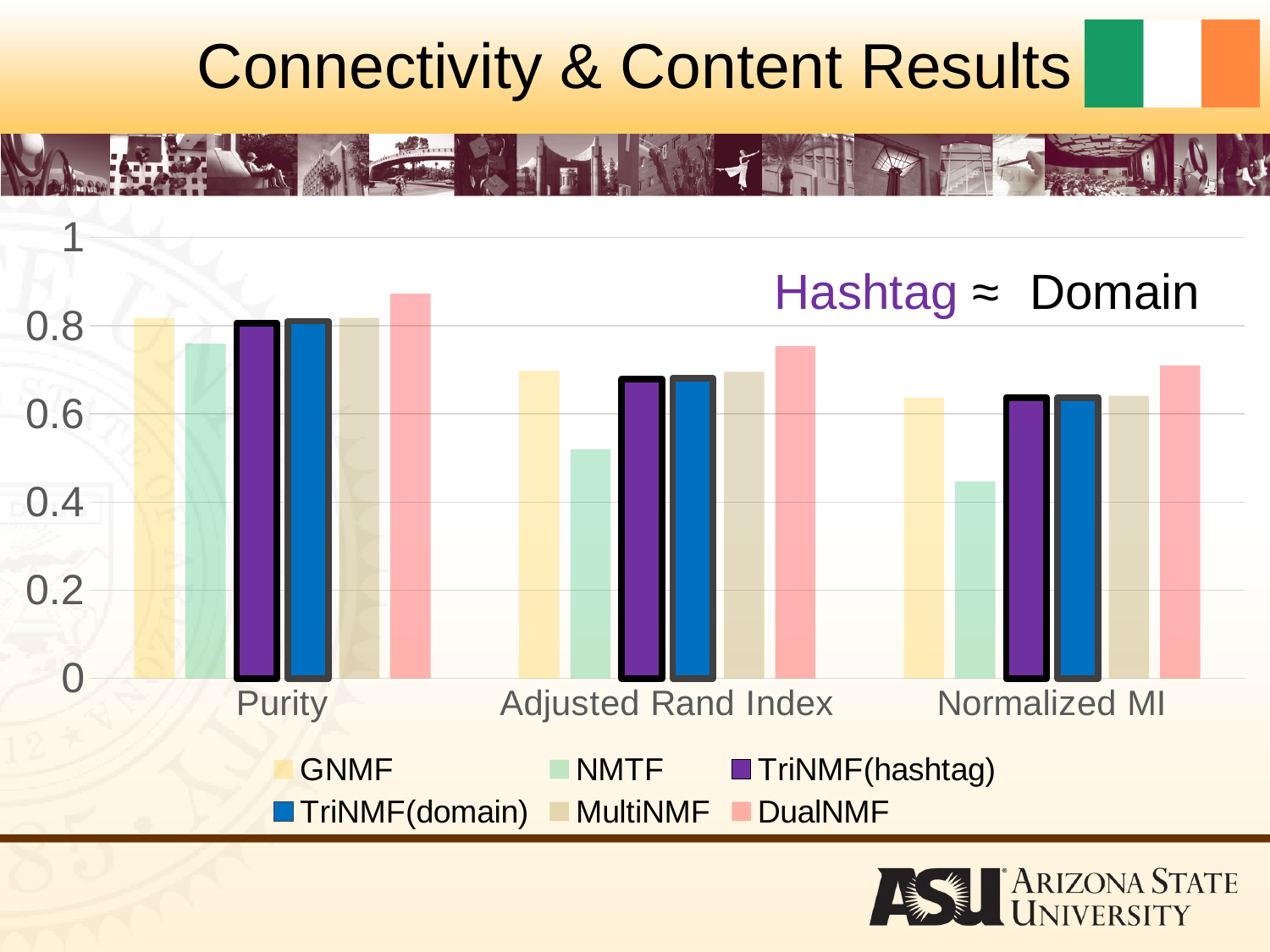
What is the title of the slide containing the chart? Connectivity & Content Results What kind of chart is shown on the slide? bar chart For Adjusted Rand Index, which is larger: the DualNMF value or the NMTF value? DualNMF Is the NMTF value for Adjusted Rand Index greater or less than 0.6? less Is the DualNMF value for Purity greater or less than 0.8? greater Which series has the lowest value for Adjusted Rand Index? NMTF Which series has the lowest value for Normalized MI? NMTF How many series does the legend list? 6 How many categories are shown along the x axis? 3 Is the NMTF value for Normalized MI greater or less than 0.6? less Which series has the highest value for Normalized MI? DualNMF Which series has the highest value for Purity? DualNMF